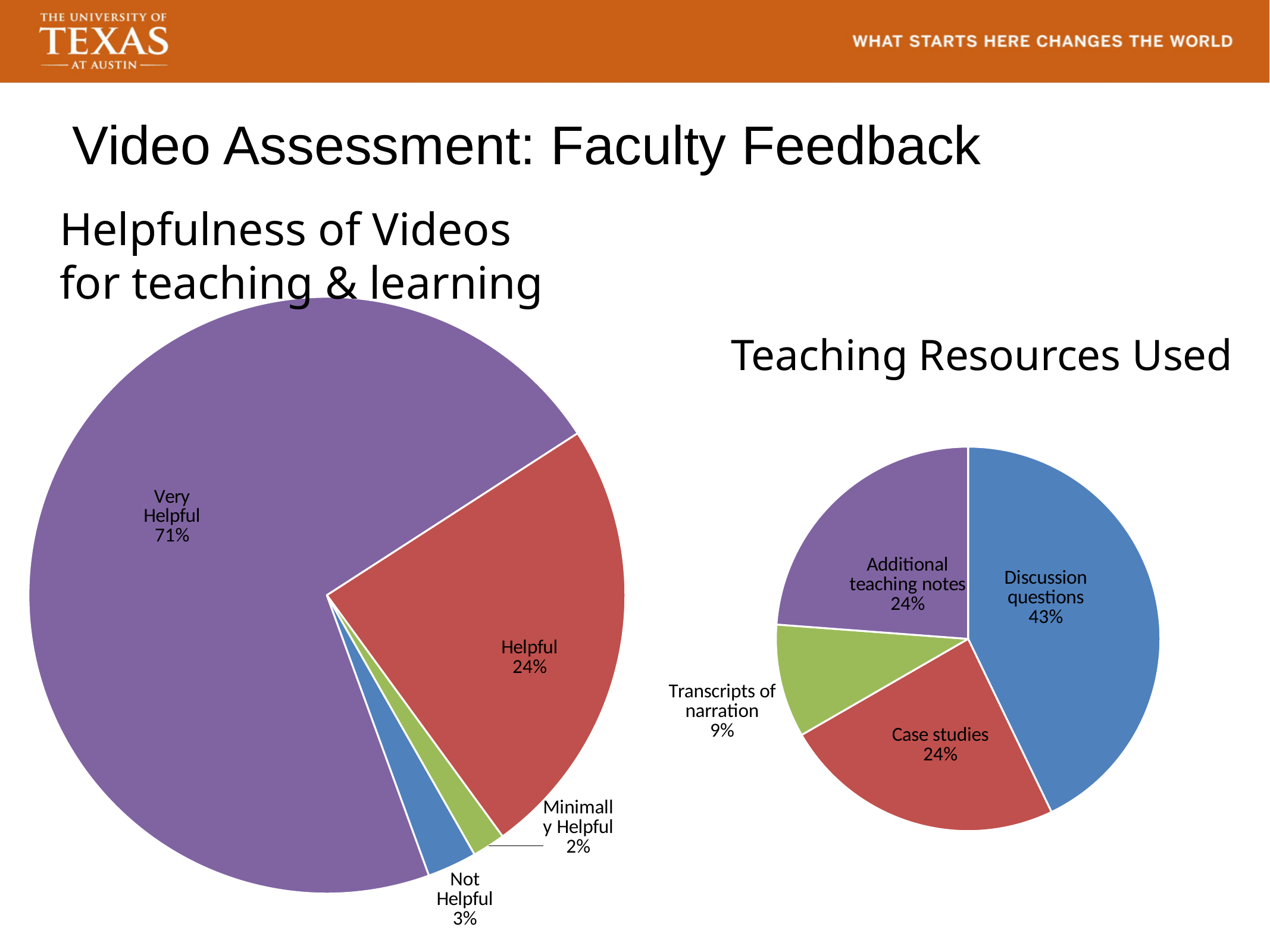
In the "Helpfulness of Videos for teaching & learning" chart, what share of responses is "Very Helpful"? 71% In the "Helpfulness of Videos for teaching & learning" chart, what share of responses is "Not Helpful"? 3% In the "Helpfulness of Videos for teaching & learning" chart, which category has the smallest slice? Minimally Helpful In the "Teaching Resources Used" chart, which resource has the largest share? Discussion questions In the "Helpfulness of Videos for teaching & learning" chart, which category has the largest slice? Very Helpful In the "Teaching Resources Used" chart, what share is "Transcripts of narration"? 9% In the "Teaching Resources Used" chart, what is the difference between the "Discussion questions" and "Case studies" shares? 19% In the "Helpfulness of Videos for teaching & learning" chart, what is the difference between the "Very Helpful" and "Helpful" shares? 47% In the "Helpfulness of Videos for teaching & learning" chart, how many slices does the pie have? 4 In the "Teaching Resources Used" chart, which resource has the smallest share? Transcripts of narration What kind of chart is the "Teaching Resources Used" chart? Pie chart